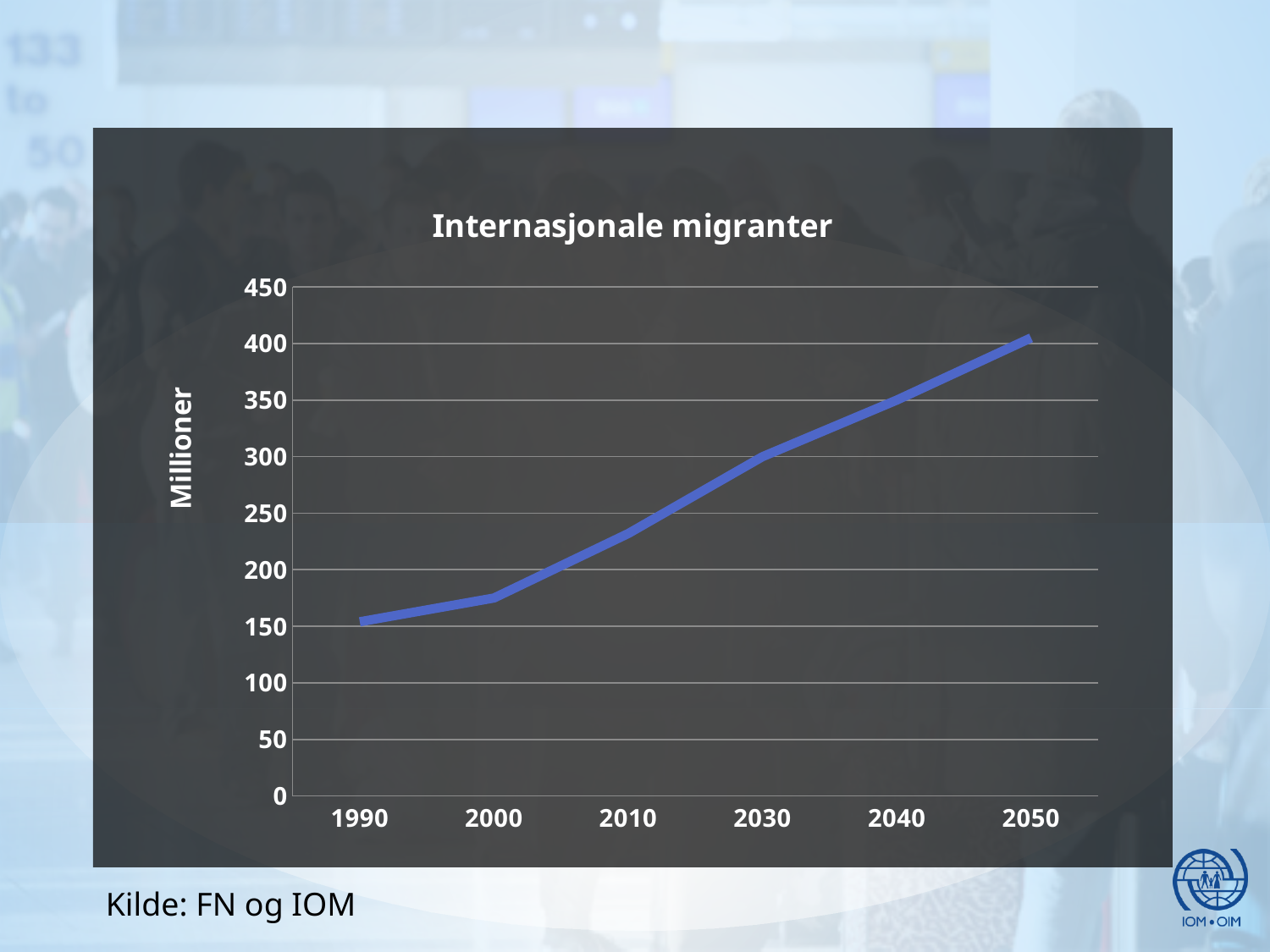
Is the value for 2010 greater or less than 200? greater Is the value for 2030 greater or less than 250? greater What is the title of the chart? Internasjonale migranter What kind of chart is shown on the slide? line chart Which year has the lowest value in the chart? 1990 What is the label on the vertical axis of the chart? Millioner Which is larger, the value for 2010 or the value for 2040? 2040 How many years are plotted along the x axis of the chart? 6 Do the values rise or fall from 1990 to 2050? rise Is the value for 2050 greater or less than 350? greater Which year has the highest value in the chart? 2050